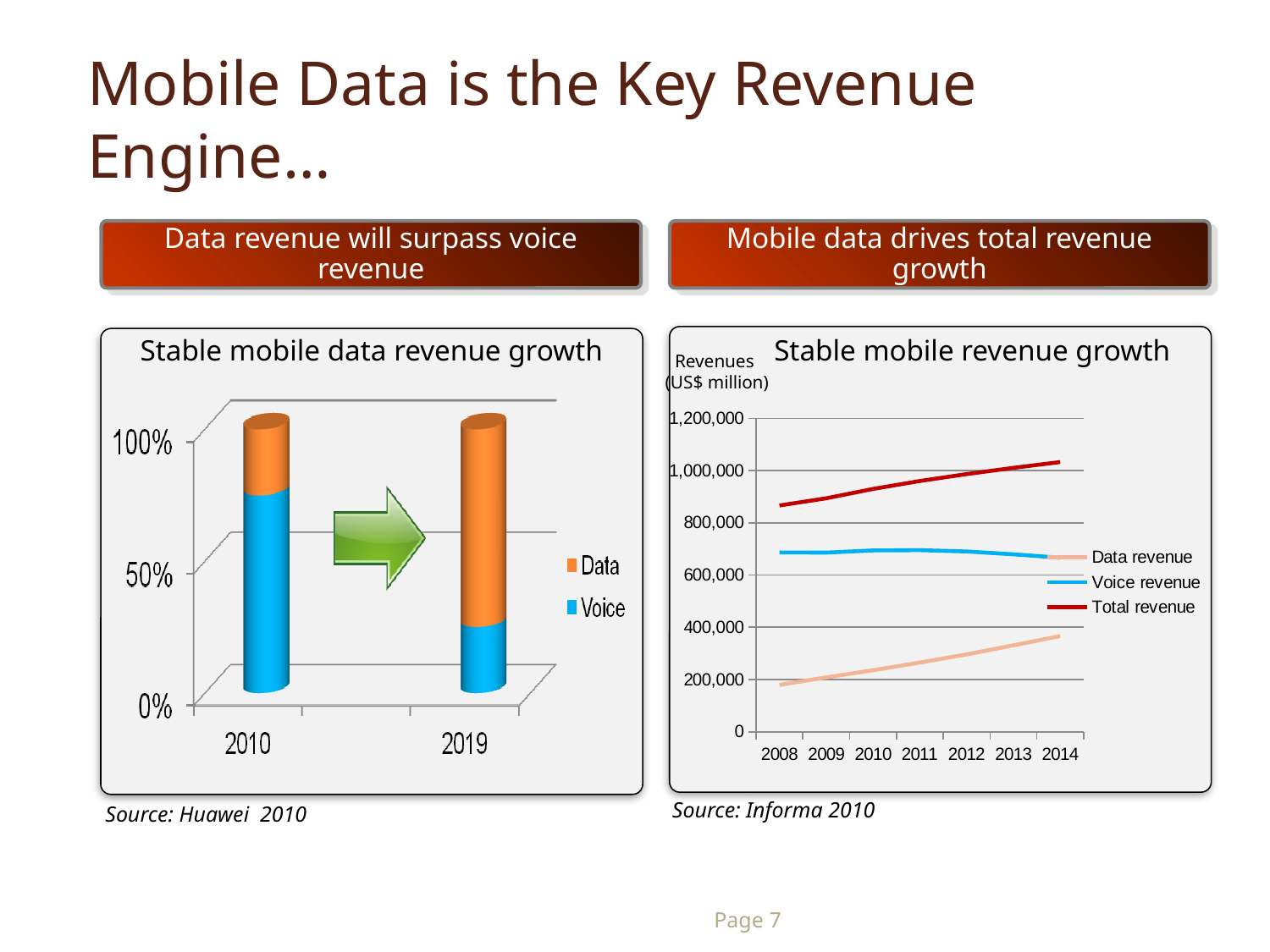
In the left chart 'Stable mobile data revenue growth', how many series does the legend list? 2 What kind of chart is the left chart titled 'Stable mobile data revenue growth'? bar chart In the left chart 'Stable mobile data revenue growth', which is larger in 2019, the Data share or the Voice share? Data In the right chart 'Stable mobile revenue growth', does Total revenue rise or fall from 2008 to 2014? rise In the left chart 'Stable mobile data revenue growth', how many years are shown on the x axis? 2 In the left chart 'Stable mobile data revenue growth', which is larger in 2010, the Voice share or the Data share? Voice In the right chart 'Stable mobile revenue growth', which series has the lowest values across all years? Data revenue In the left chart 'Stable mobile data revenue growth', is the Voice share in 2010 greater or less than 50%? greater In the right chart 'Stable mobile revenue growth', how many years are shown on the x axis? 7 What kind of chart is the right chart titled 'Stable mobile revenue growth'? line chart In the right chart 'Stable mobile revenue growth', is Total revenue in 2014 greater or less than 1,000,000? greater In the right chart 'Stable mobile revenue growth', how many series does the legend list? 3